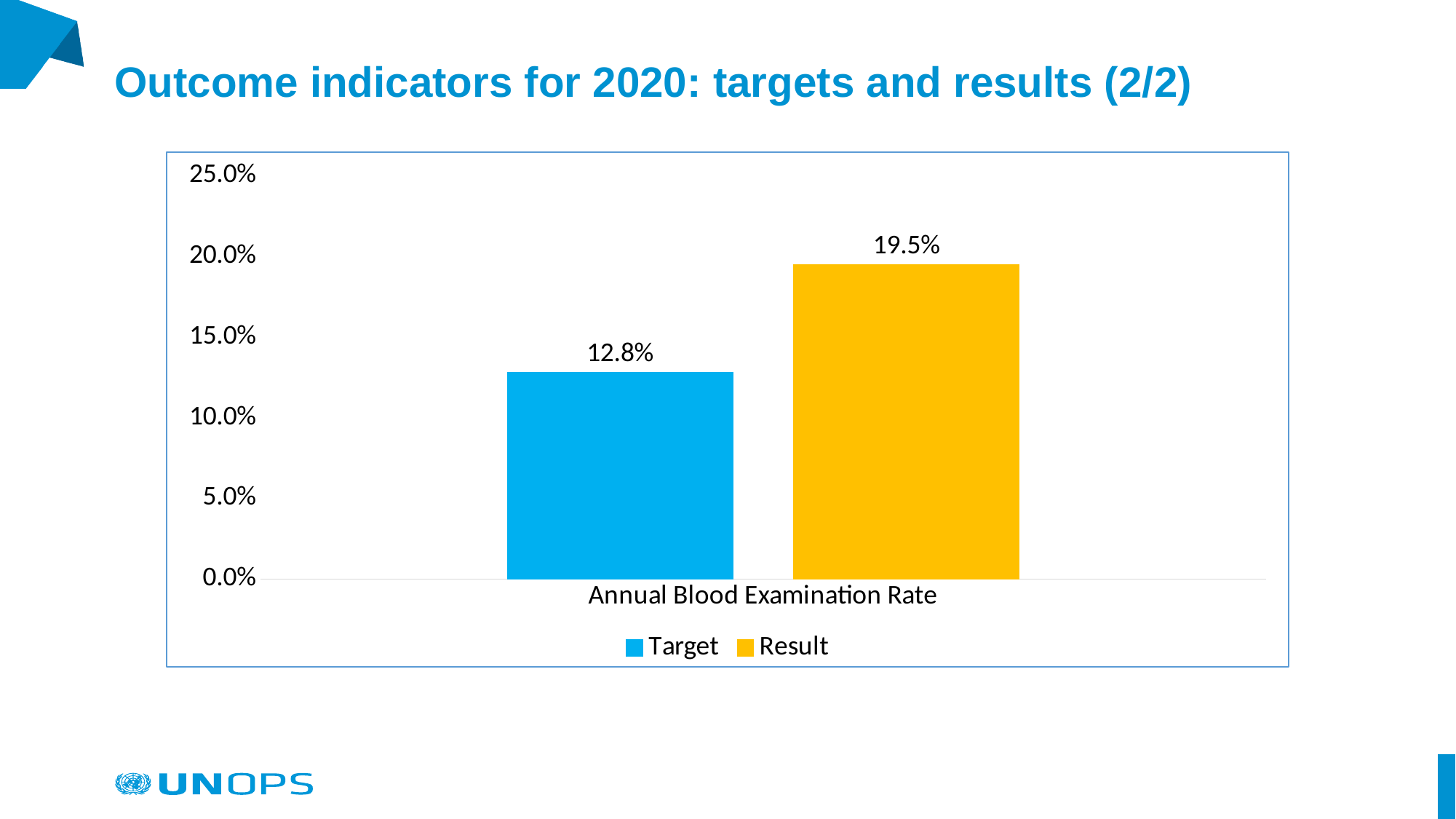
Which series has the higher value for Annual Blood Examination Rate, Target or Result? Result What kind of chart is shown on the slide? Bar chart Is the Target value for Annual Blood Examination Rate greater or less than 15.0%? less Which colour represents the Result series in the legend? Yellow What is the name of the category shown on the x axis? Annual Blood Examination Rate Is the Result value for Annual Blood Examination Rate greater or less than 15.0%? greater What is the highest value shown on the y axis? 25.0% What is the Target value for Annual Blood Examination Rate? 12.8% How many categories are shown on the x axis? 1 How many series does the legend list? 2 What is the difference between the Result and the Target for Annual Blood Examination Rate? 6.7% What is the Result value for Annual Blood Examination Rate? 19.5%